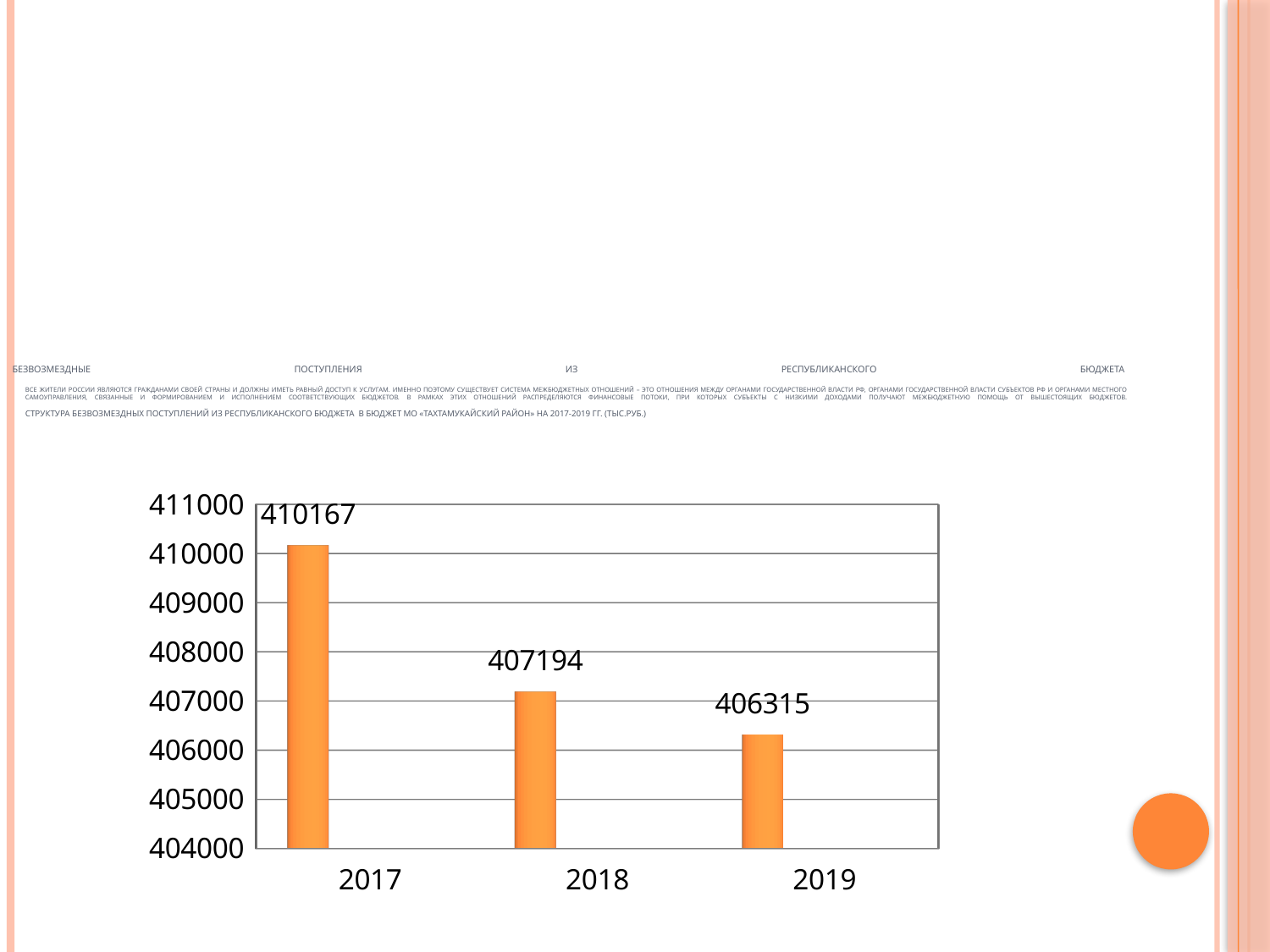
Do the values rise or fall from 2017 to 2019? fall Which is larger, the value for 2018 or the value for 2019? 2018 Which year has the lowest value? 2019 What is the value for 2019? 406315 What is the value for 2017? 410167 How many years are shown on the x axis? 3 What is the difference between the values for 2017 and 2018? 2973 What kind of chart is shown on the slide? bar chart What is the difference between the values for 2018 and 2019? 879 What is the value for 2018? 407194 Which year has the highest value? 2017 Is the value for 2019 greater or less than 407000? less